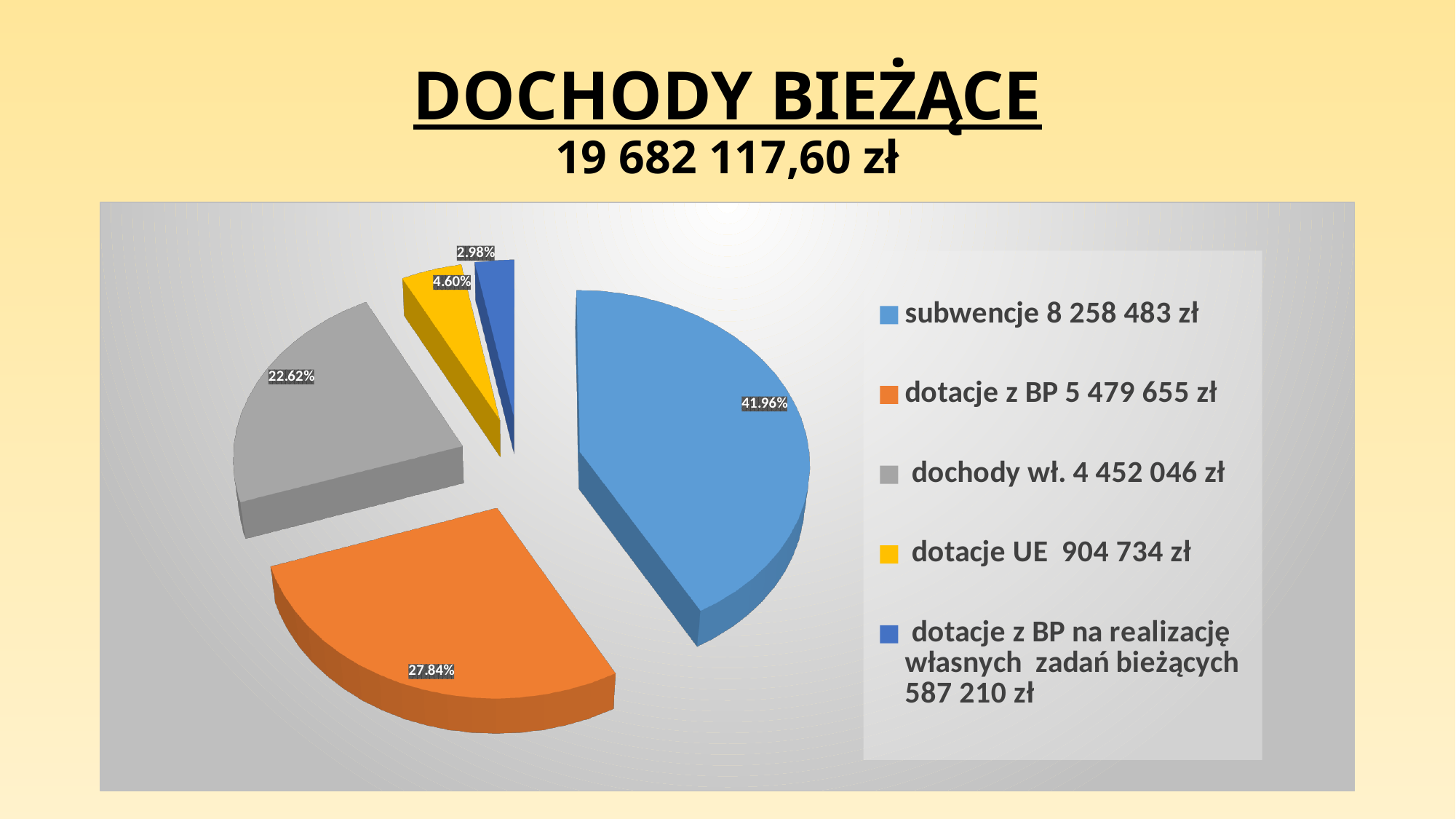
What type of chart is shown on the slide? pie chart How many slices does the pie chart have? 5 Which category has the smallest share of the pie? dotacje z BP na realizację własnych zadań bieżących What percentage share does the 'dotacje UE' slice have? 4.60% What is the value shown in the legend for 'dotacje z BP'? 5 479 655 zł Which is larger, the share for 'dochody wł.' or the share for 'dotacje UE'? dochody wł. Which category has the largest share of the pie? subwencje What percentage share does the 'dotacje z BP na realizację własnych zadań bieżących' slice have? 2.98% What percentage share does the 'dotacje z BP' slice have? 27.84% What is the difference in percentage points between the 'subwencje' and 'dotacje z BP' shares? 14.12